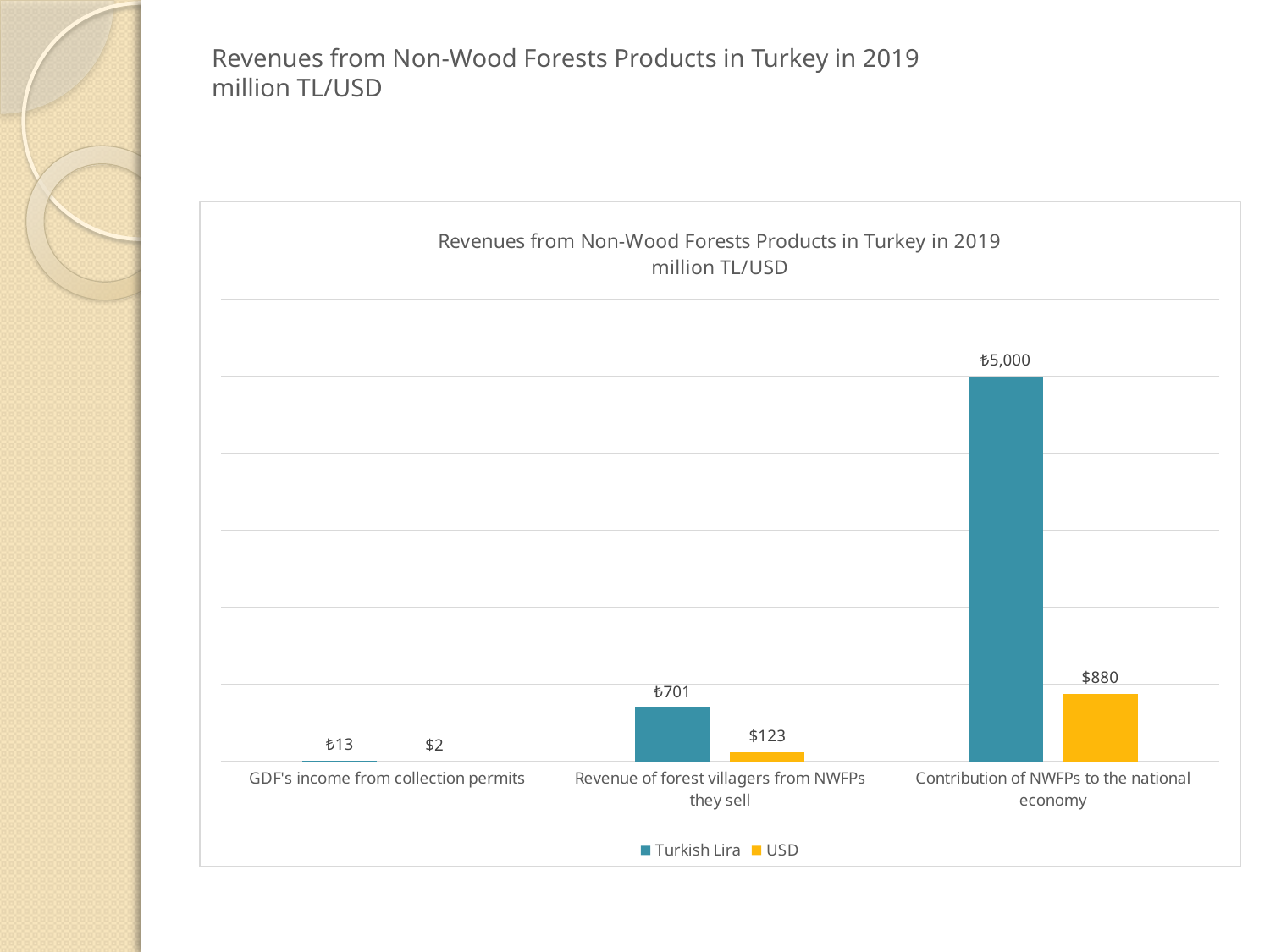
What is the Turkish Lira value for GDF's income from collection permits? ₺13 What is the difference between the Turkish Lira values for Contribution of NWFPs to the national economy and Revenue of forest villagers from NWFPs they sell? ₺4,299 What is the USD value for Contribution of NWFPs to the national economy? $880 How many categories are shown on the x axis? 3 What is the USD value for Revenue of forest villagers from NWFPs they sell? $123 Which series is shown in yellow in the legend? USD Which category has the highest Turkish Lira value? Contribution of NWFPs to the national economy What kind of chart is shown on the slide? Bar chart What is the Turkish Lira value for Contribution of NWFPs to the national economy? ₺5,000 How many series does the legend list? 2 Which is larger: the USD value for Revenue of forest villagers from NWFPs they sell or the USD value for Contribution of NWFPs to the national economy? Contribution of NWFPs to the national economy Which category has the lowest USD value? GDF's income from collection permits